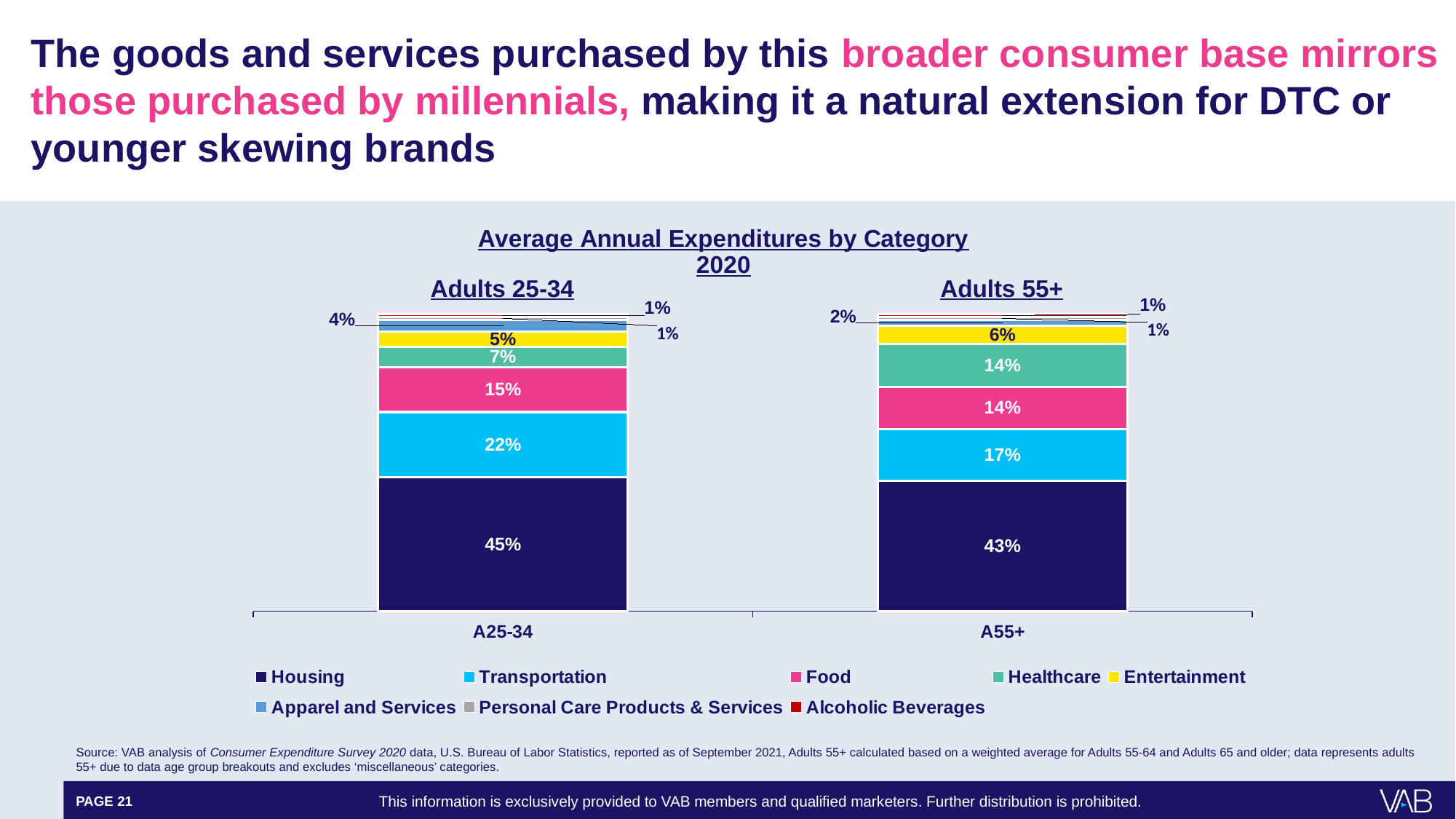
What is the Housing share for A55+? 43% What is the Entertainment share for A55+? 6% What is the Apparel and Services share for A25-34? 4% What is the Housing share for A25-34? 45% How many bars are plotted in the chart? 2 What kind of chart is shown on the slide? Stacked bar chart What is the difference between the Transportation shares for A25-34 and A55+? 5% How many series does the legend list? 8 Which group has the larger Healthcare share, A25-34 or A55+? A55+ What is the Healthcare share for A25-34? 7% What is the Transportation share for A55+? 17% Which category has the largest share for A25-34? Housing